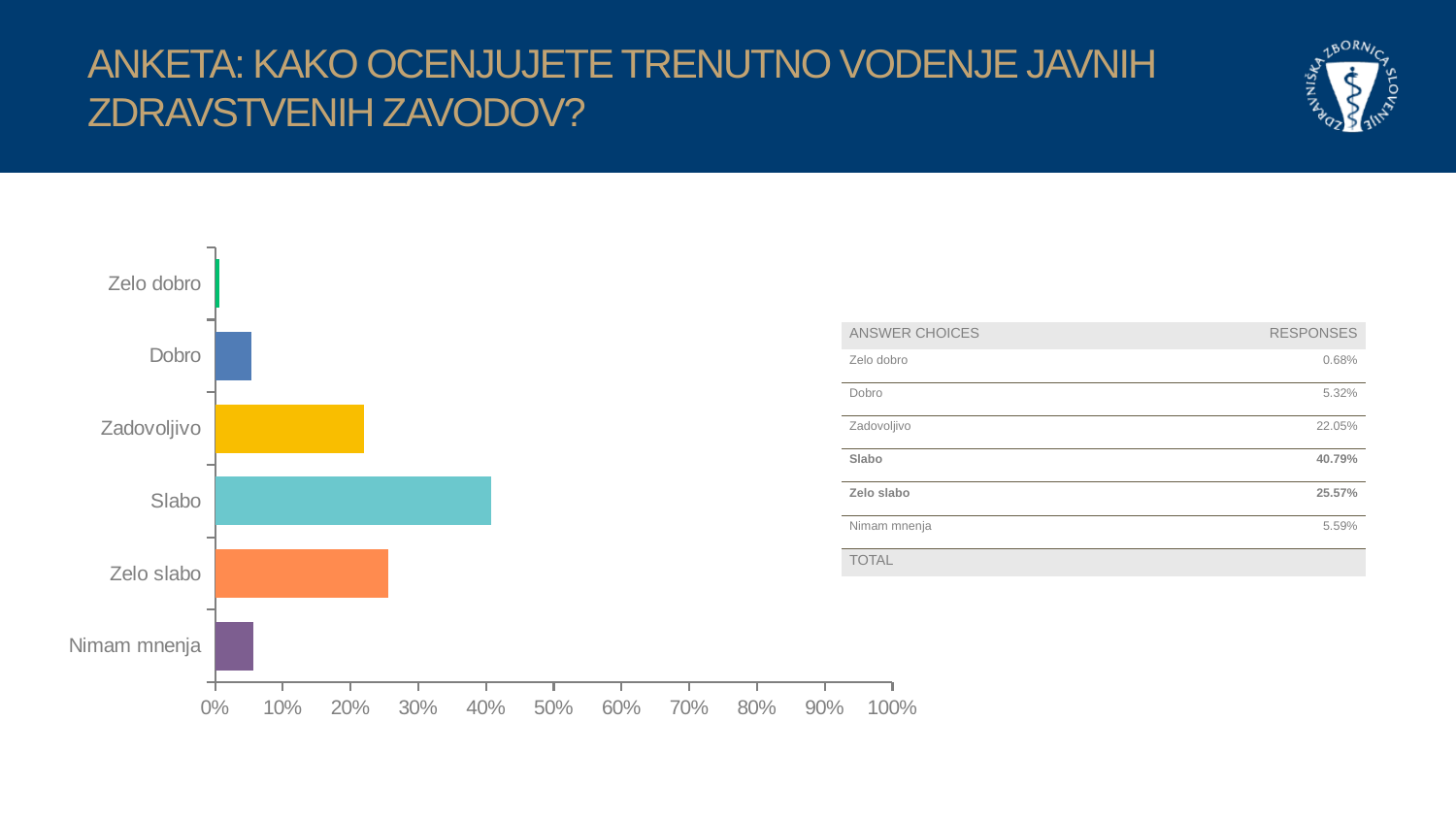
What type of chart is shown on the slide? bar chart What is the maximum value shown on the horizontal axis of the bar chart? 100% Which has a larger response share, Zadovoljivo or Zelo slabo? Zelo slabo What is the response share for Nimam mnenja? 5.59% What is the response share for Zelo dobro? 0.68% How many answer choices are plotted in the bar chart? 6 Which answer choice has the lowest response share? Zelo dobro Is the value for Zelo slabo greater or less than 20%? greater What is the response share for Slabo? 40.79% What is the difference between the response shares for Slabo and Zelo slabo? 15.22% What is the response share for Zadovoljivo? 22.05% Which answer choice has the highest response share? Slabo